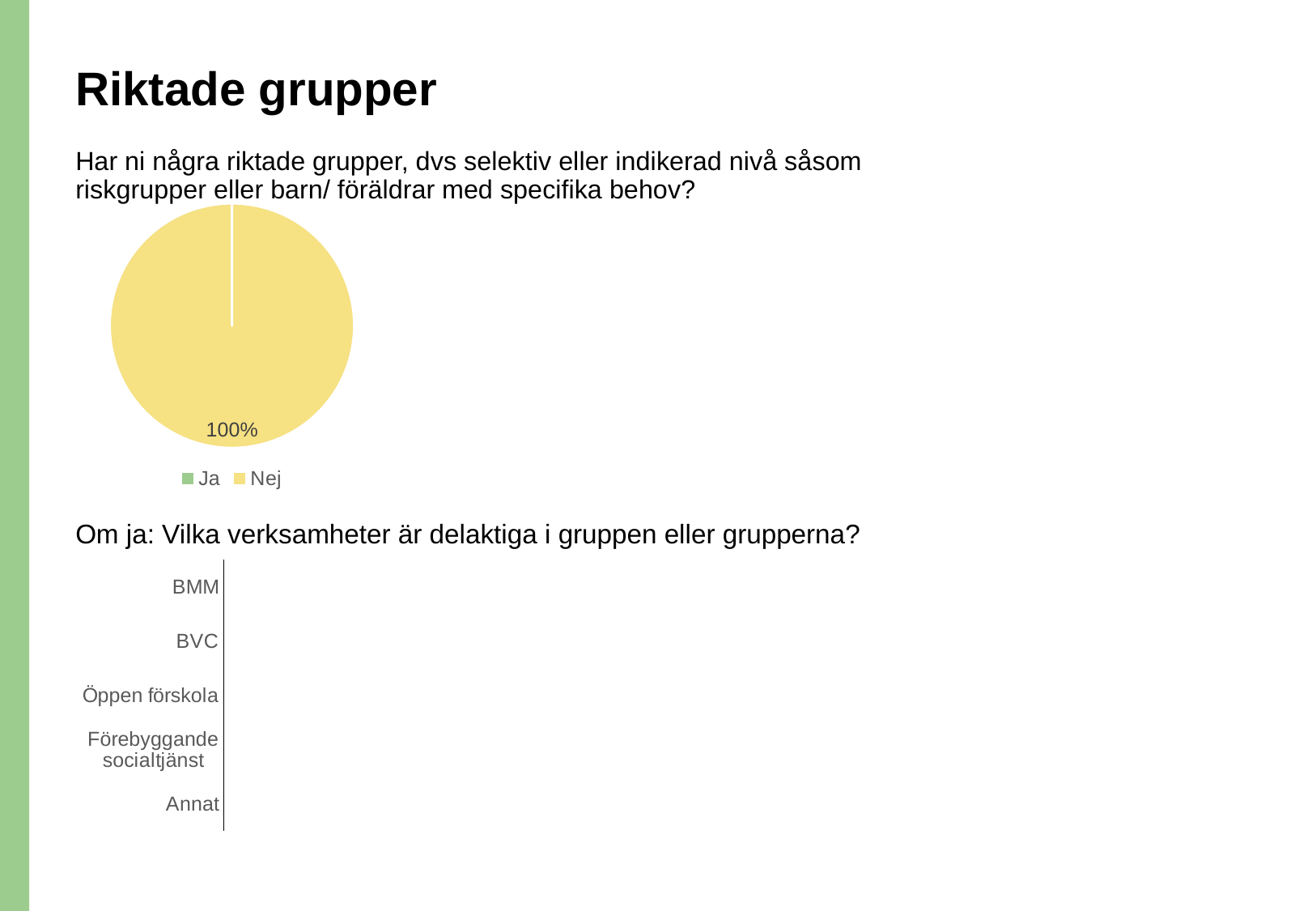
In the pie chart, what share of the pie does the Nej slice take? 100% How many categories are listed on the axis of the lower chart, under the question 'Om ja: Vilka verksamheter är delaktiga i gruppen eller grupperna?'? 5 What kind of chart is the lower chart on the slide, with the categories BMM, BVC, Öppen förskola, Förebyggande socialtjänst and Annat? bar chart In the pie chart, is the share for Nej greater or less than 50%? greater Which category is listed last (at the bottom) on the axis of the lower bar chart? Annat How many entries does the legend of the pie chart list? 2 What kind of chart is the upper chart on the slide, below the question about riktade grupper? pie chart What colour is the Nej slice in the pie chart? yellow What are the two legend entries of the pie chart? Ja and Nej In the pie chart, which category makes up the whole pie? Nej